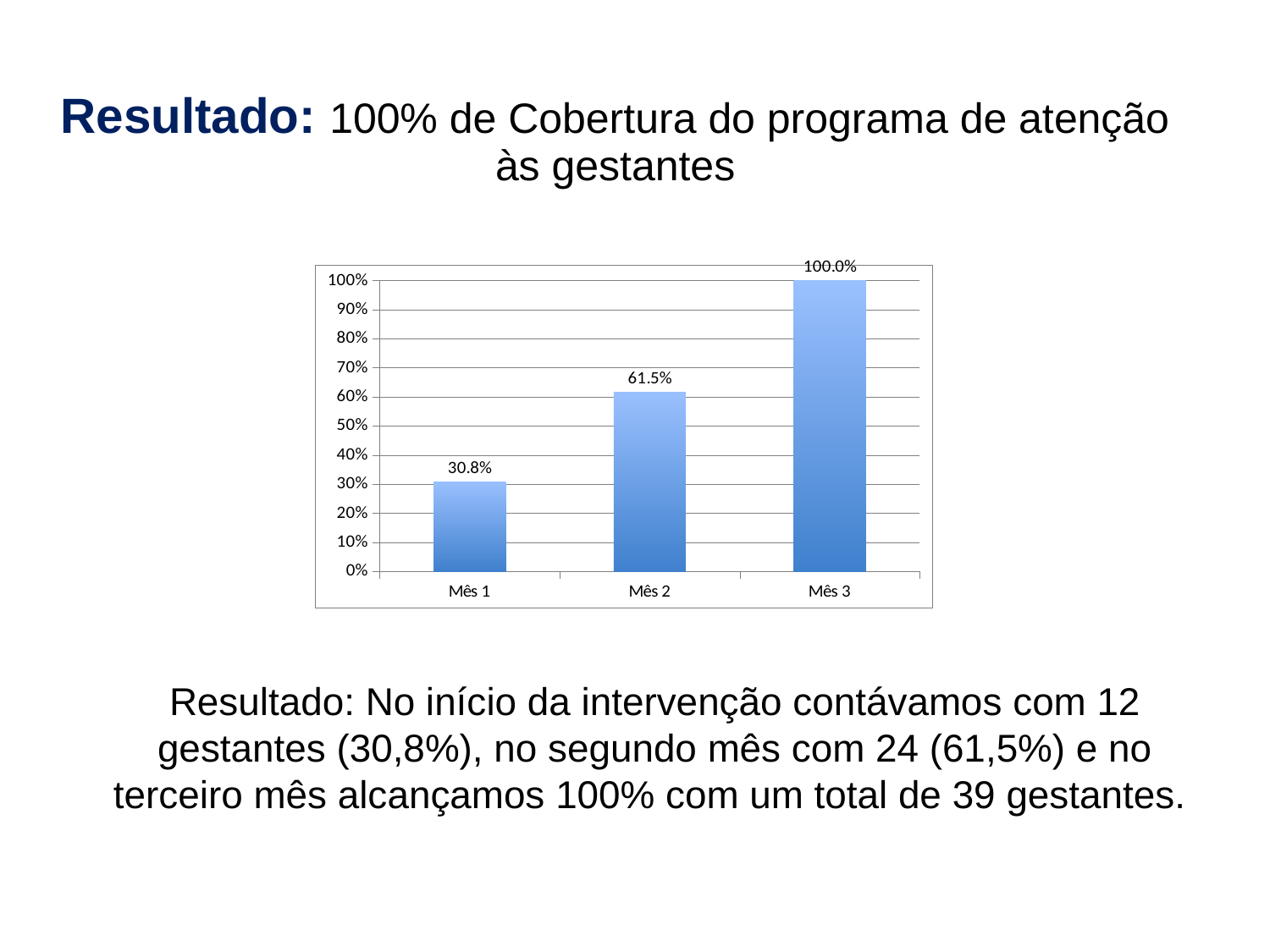
What is the value for Mês 2? 61.5% Which is larger, the value for Mês 1 or the value for Mês 2? Mês 2 What is the value for Mês 1? 30.8% Do the values rise or fall from Mês 1 to Mês 3? rise What is the difference between the values for Mês 2 and Mês 1? 30.7% What kind of chart is shown on the slide? bar chart Which month has the lowest value? Mês 1 What is the value for Mês 3? 100.0% What is the difference between the values for Mês 3 and Mês 2? 38.5% How many categories are shown on the x axis? 3 Is the value for Mês 2 greater or less than 50%? greater Which month has the highest value? Mês 3